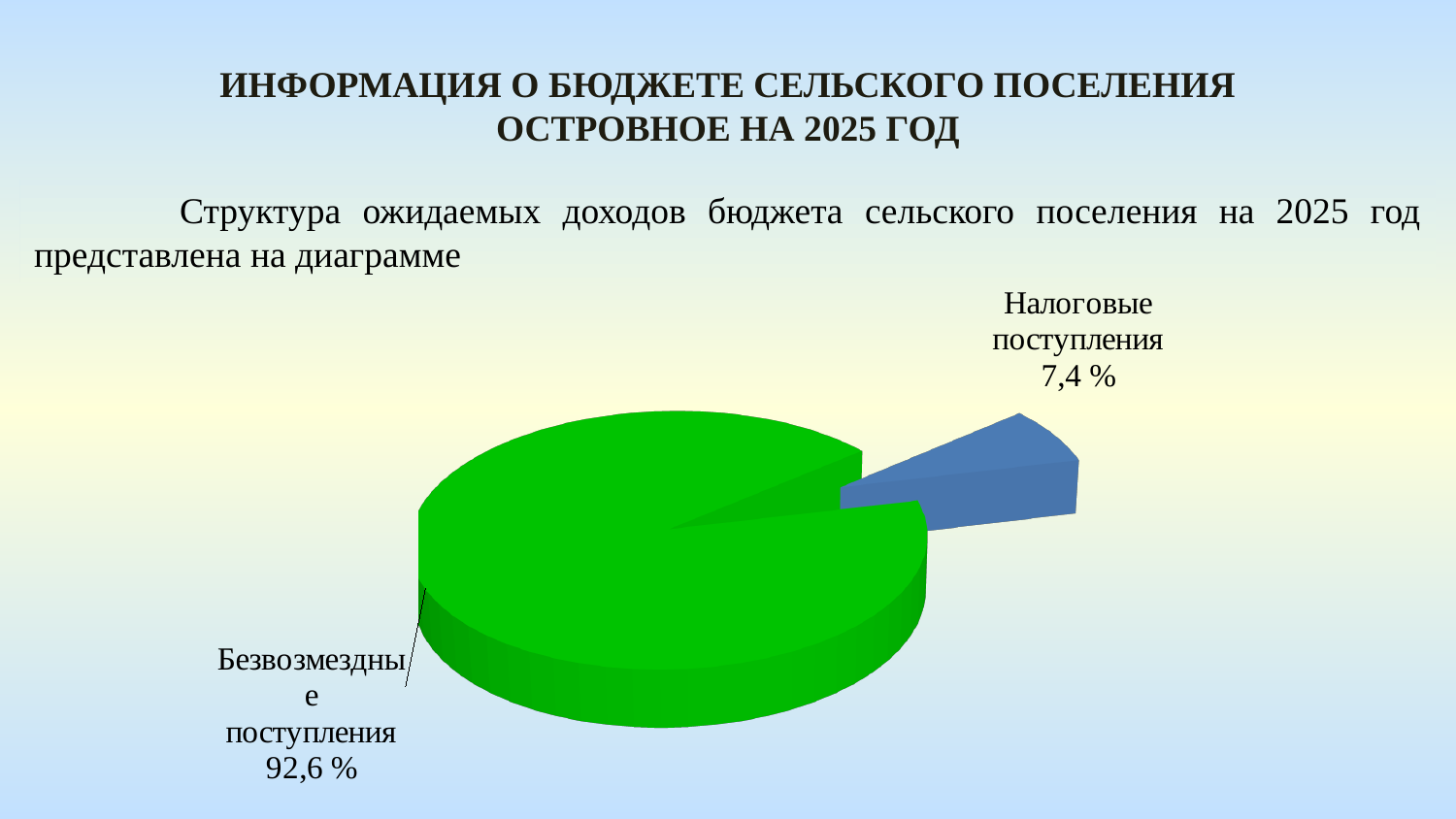
What share of the pie is labelled "Налоговые поступления"? 7,4 % What kind of chart is shown on the slide? Pie chart Is the share for "Безвозмездные поступления" greater or less than 90 %? greater Which slice of the pie is the largest? Безвозмездные поступления Which is larger: "Налоговые поступления" or "Безвозмездные поступления"? Безвозмездные поступления What colour is the slice for "Безвозмездные поступления"? Green How many slices does the pie chart have? 2 Is the share for "Налоговые поступления" greater or less than 10 %? less What colour is the slice for "Налоговые поступления"? Blue What share of the pie is labelled "Безвозмездные поступления"? 92,6 % Which slice of the pie is the smallest? Налоговые поступления What is the difference in percentage points between "Безвозмездные поступления" and "Налоговые поступления"? 85,2